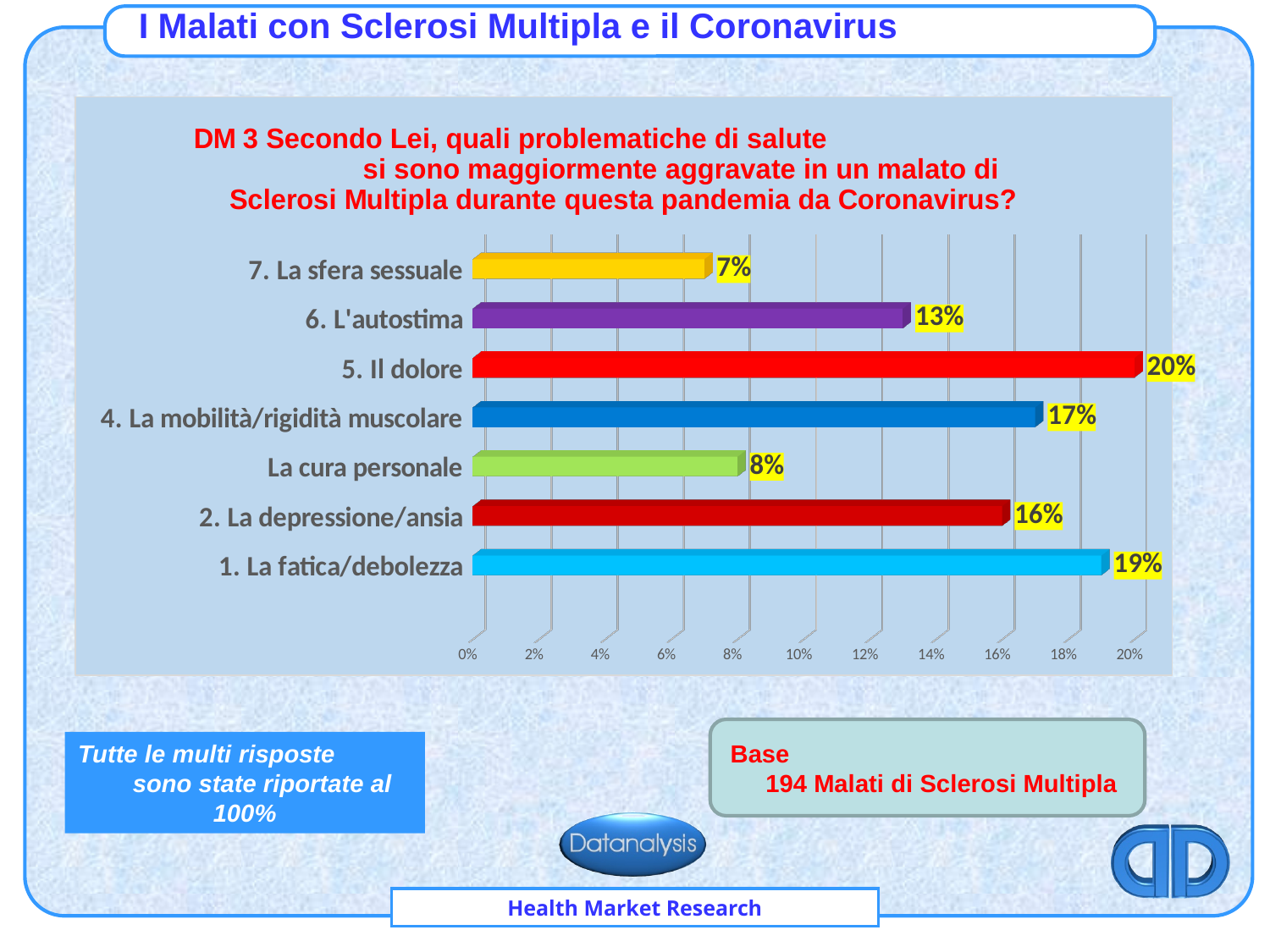
Which is larger, the value for "6. L'autostima" or the value for "La cura personale"? 6. L'autostima What is the value for "5. Il dolore"? 20% What is the value for "La cura personale"? 8% Which category has the lowest value? 7. La sfera sessuale What is the difference between the values for "4. La mobilità/rigidità muscolare" and "2. La depressione/ansia"? 1% What is the value for "1. La fatica/debolezza"? 19% Which category has the highest value? 5. Il dolore What kind of chart is shown on the slide? bar chart What is the value for "6. L'autostima"? 13% How many categories are shown in the chart? 7 What is the base (number of respondents) stated on the slide? 194 Malati di Sclerosi Multipla Is the value for "2. La depressione/ansia" greater or less than 10%? greater